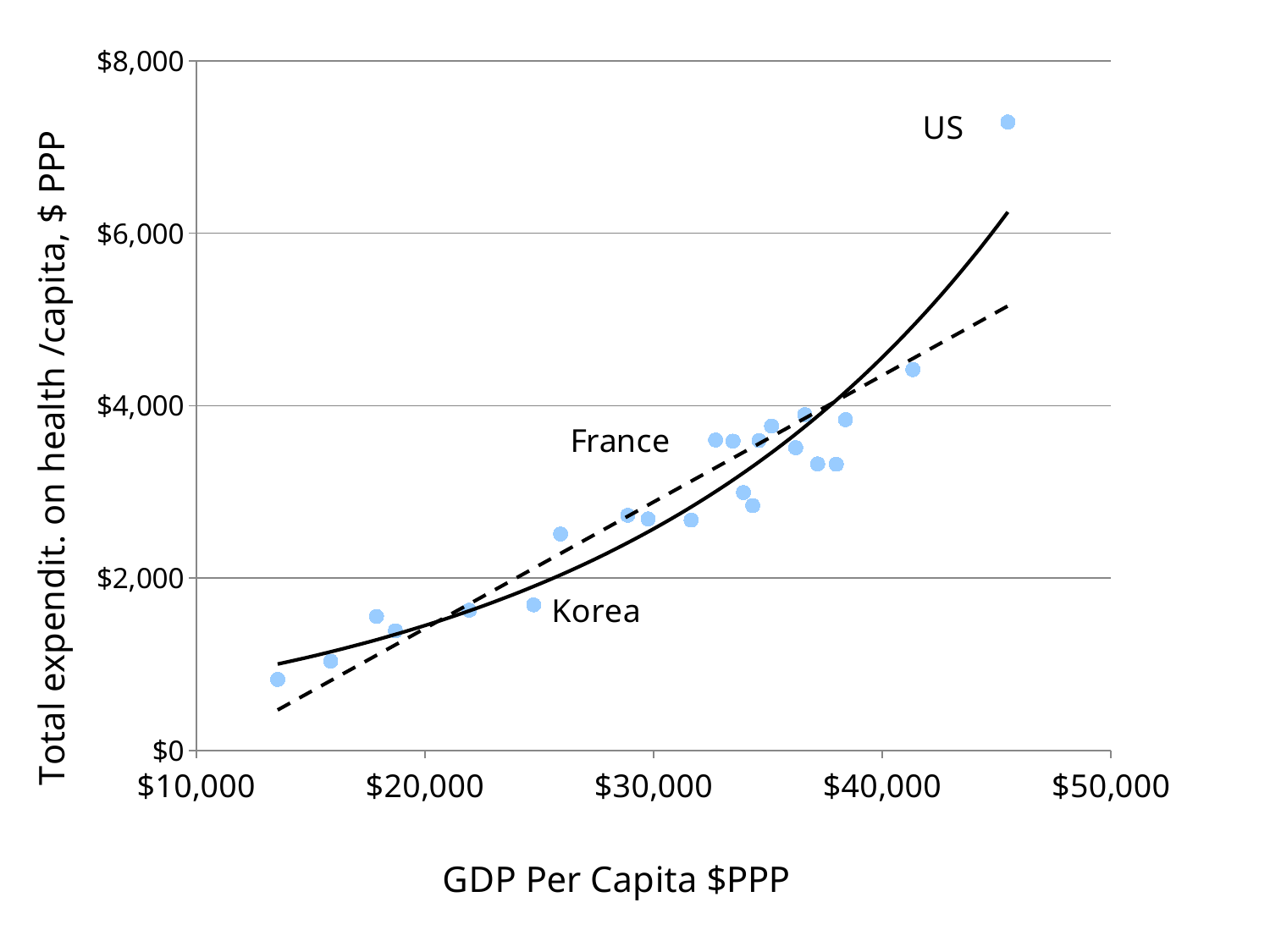
What kind of chart is shown on the slide? scatter chart Which has a higher total expenditure on health per capita, the US or Korea? US Is the GDP per capita for the US greater or less than $40,000? greater What is the title of the x axis? GDP Per Capita $PPP How many countries are labeled by name on the chart? 3 Do the plotted values generally rise or fall as GDP per capita increases? rise Is the GDP per capita for Korea greater or less than $30,000? less Is the total expenditure on health per capita for the US greater or less than $6,000? greater Which labeled country has the highest total expenditure on health per capita? US Which has a higher total expenditure on health per capita, the US or France? US